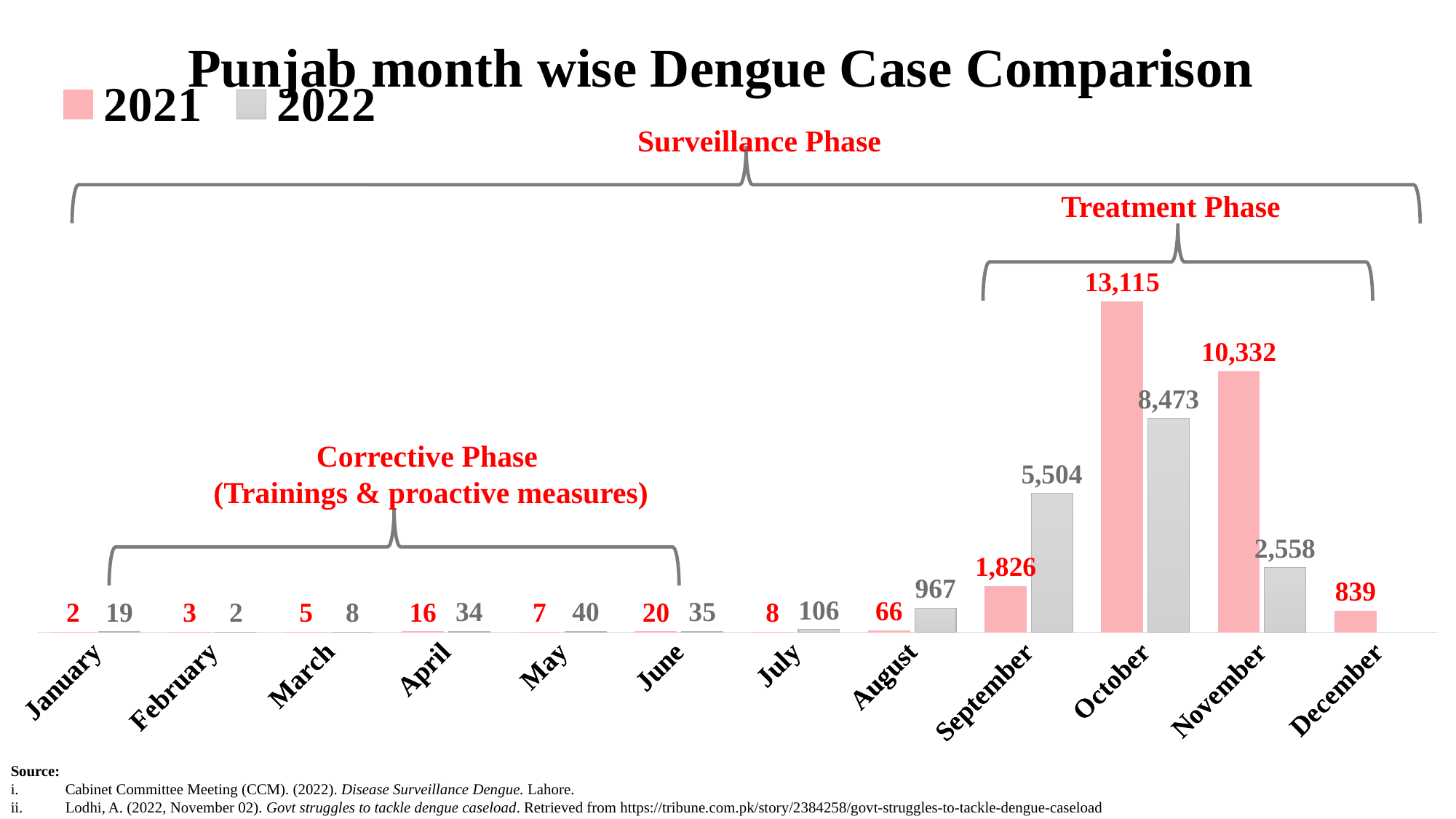
Which month had the highest number of dengue cases in 2022? October What was the number of dengue cases in Punjab in September 2022? 5,504 Which month had the highest number of dengue cases in 2021? October Which month had the lowest number of dengue cases in 2022? February What is the difference between the 2021 and 2022 dengue case counts for November? 7,774 What was the number of dengue cases in Punjab in August 2022? 967 How many series does the legend list? 2 What was the number of dengue cases in Punjab in October 2021? 13,115 Which year had more dengue cases in September, 2021 or 2022? 2022 How many months are shown on the x axis? 12 What kind of chart is shown on the slide? Bar chart Which colour represents the 2022 series in the chart? Grey